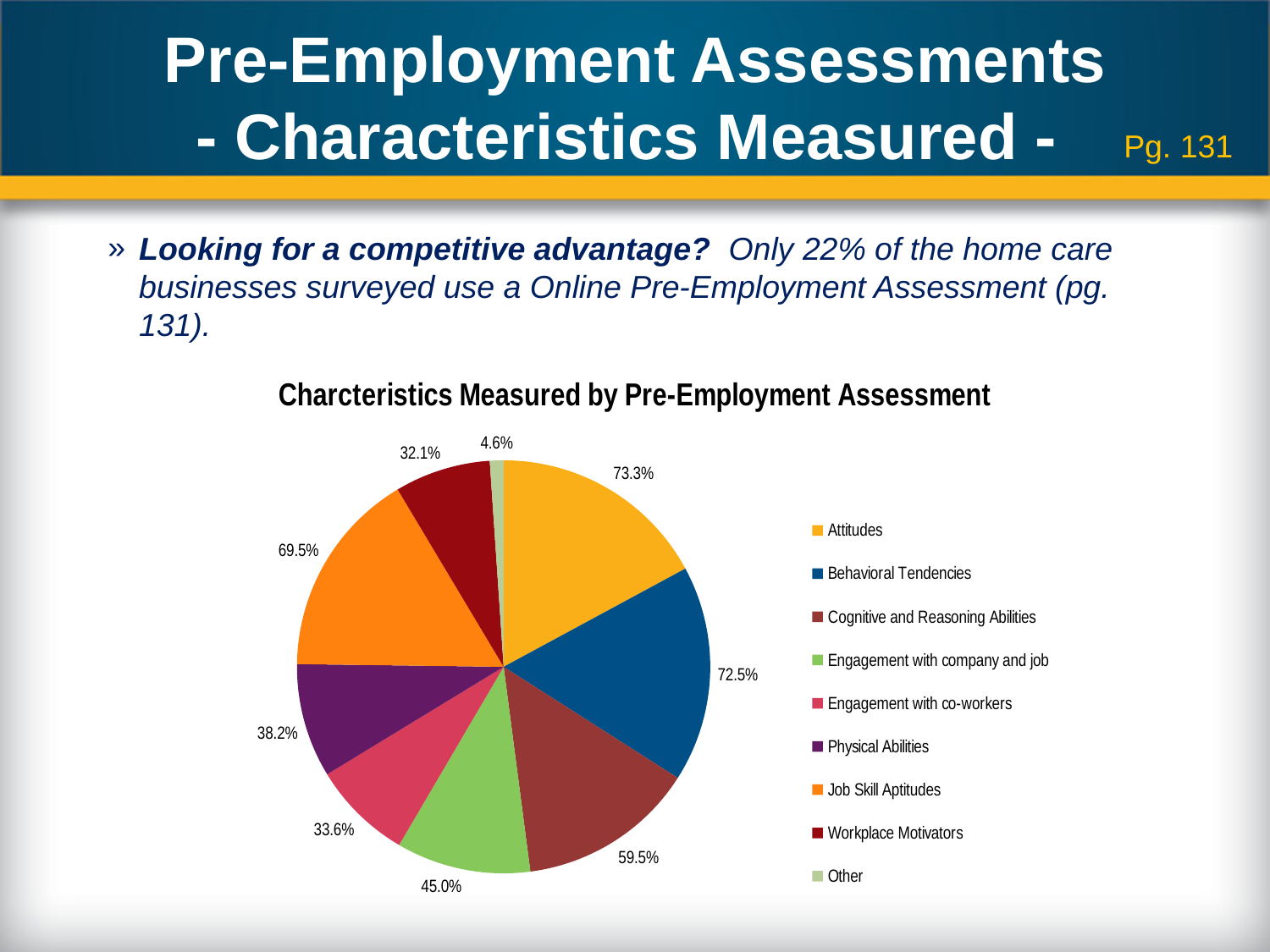
What type of chart is shown on the slide? pie chart Which is larger, Physical Abilities or Engagement with co-workers? Physical Abilities What value is shown for Engagement with company and job? 45.0% What value is shown for Cognitive and Reasoning Abilities? 59.5% Which category has the lowest value in the pie chart? Other What value is shown for Attitudes? 73.3% How many categories does the pie chart's legend list? 9 What is the title of the chart? Charcteristics Measured by Pre-Employment Assessment Which category has the highest value in the pie chart? Attitudes What is the difference between the values for Job Skill Aptitudes and Cognitive and Reasoning Abilities? 10.0% What value is shown for Behavioral Tendencies? 72.5% What value is shown for Workplace Motivators? 32.1%